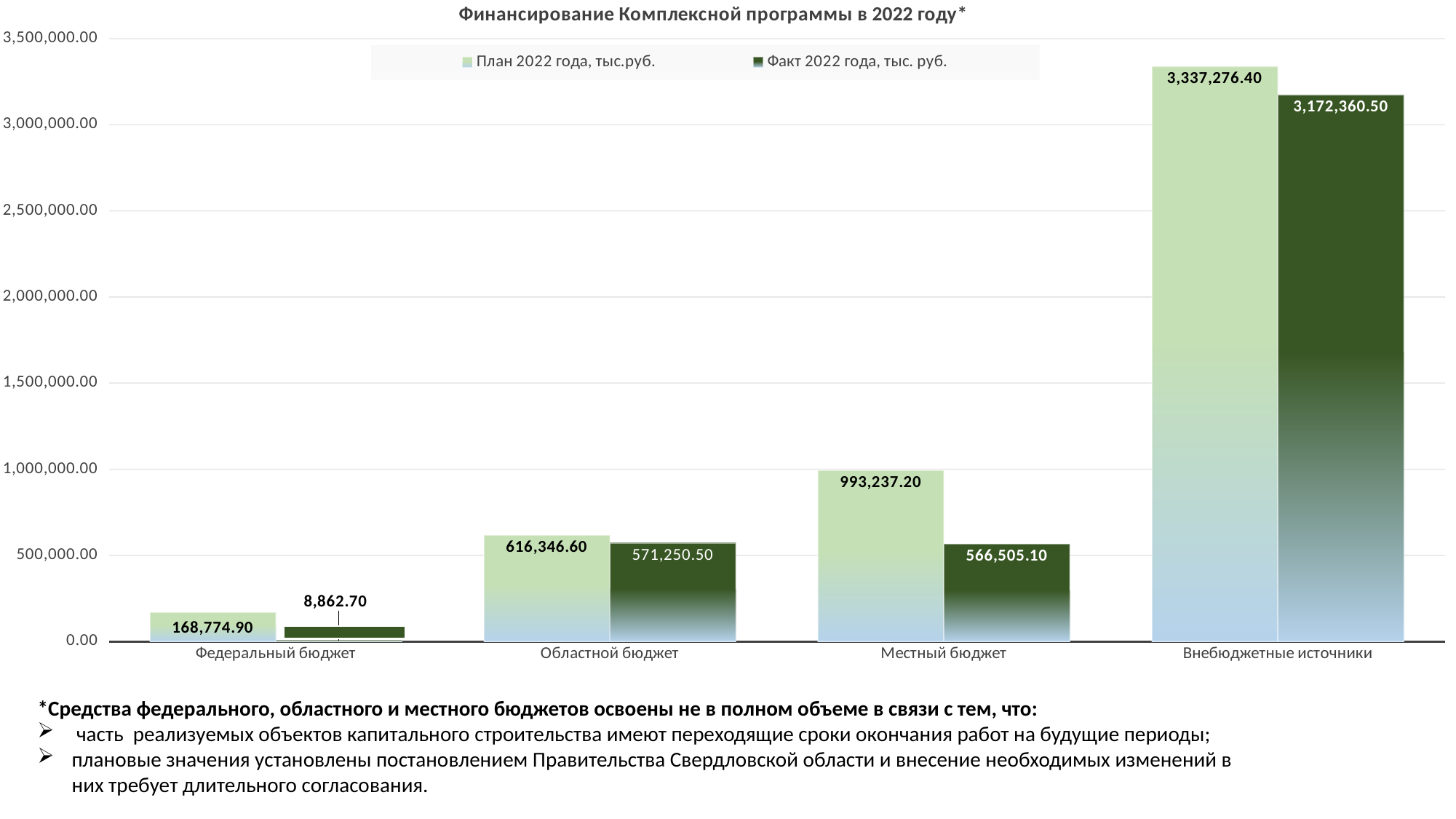
How many categories are shown on the x axis? 4 What is the План 2022 года value for Местный бюджет? 993,237.20 What is the difference between the План 2022 года and Факт 2022 года values for Внебюджетные источники? 164,915.90 Which category has the lowest План 2022 года value? Федеральный бюджет Which category has the highest Факт 2022 года value? Внебюджетные источники Which is larger: the Факт 2022 года value for Областной бюджет or the Факт 2022 года value for Местный бюджет? Областной бюджет What is the План 2022 года value for Федеральный бюджет? 168,774.90 What is the Факт 2022 года value for Федеральный бюджет? 8,862.70 What type of chart is shown on the slide? bar chart What is the Факт 2022 года value for Областной бюджет? 571,250.50 What is the difference between the План 2022 года and Факт 2022 года values for Местный бюджет? 426,732.10 How many series does the legend list? 2